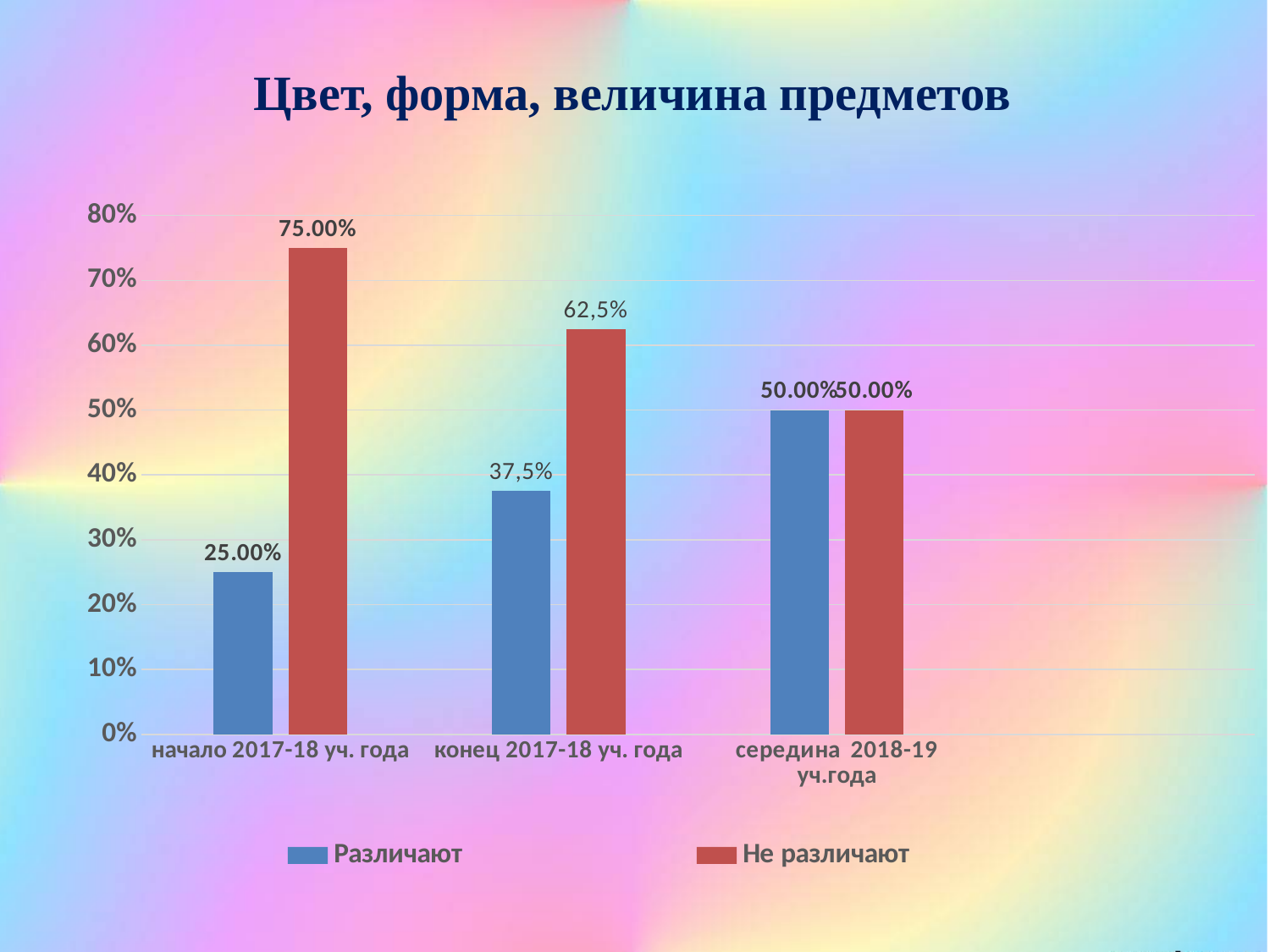
What is the value for Не различают at начало 2017-18 уч. года? 75.00% How many series does the legend list? 2 How many categories are shown on the x axis? 3 What is the value for Различают at конец 2017-18 уч. года? 37,5% What is the value for Различают at середина 2018-19 уч.года? 50.00% In which category is the Различают series lowest? начало 2017-18 уч. года What is the value for Различают at начало 2017-18 уч. года? 25.00% What is the value for Не различают at конец 2017-18 уч. года? 62,5% What is the difference between Не различают and Различают at начало 2017-18 уч. года? 50.00% At конец 2017-18 уч. года, which series has the larger value, Различают or Не различают? Не различают Does the Различают series rise or fall across the categories from left to right? rise In which category is the Не различают series highest? начало 2017-18 уч. года